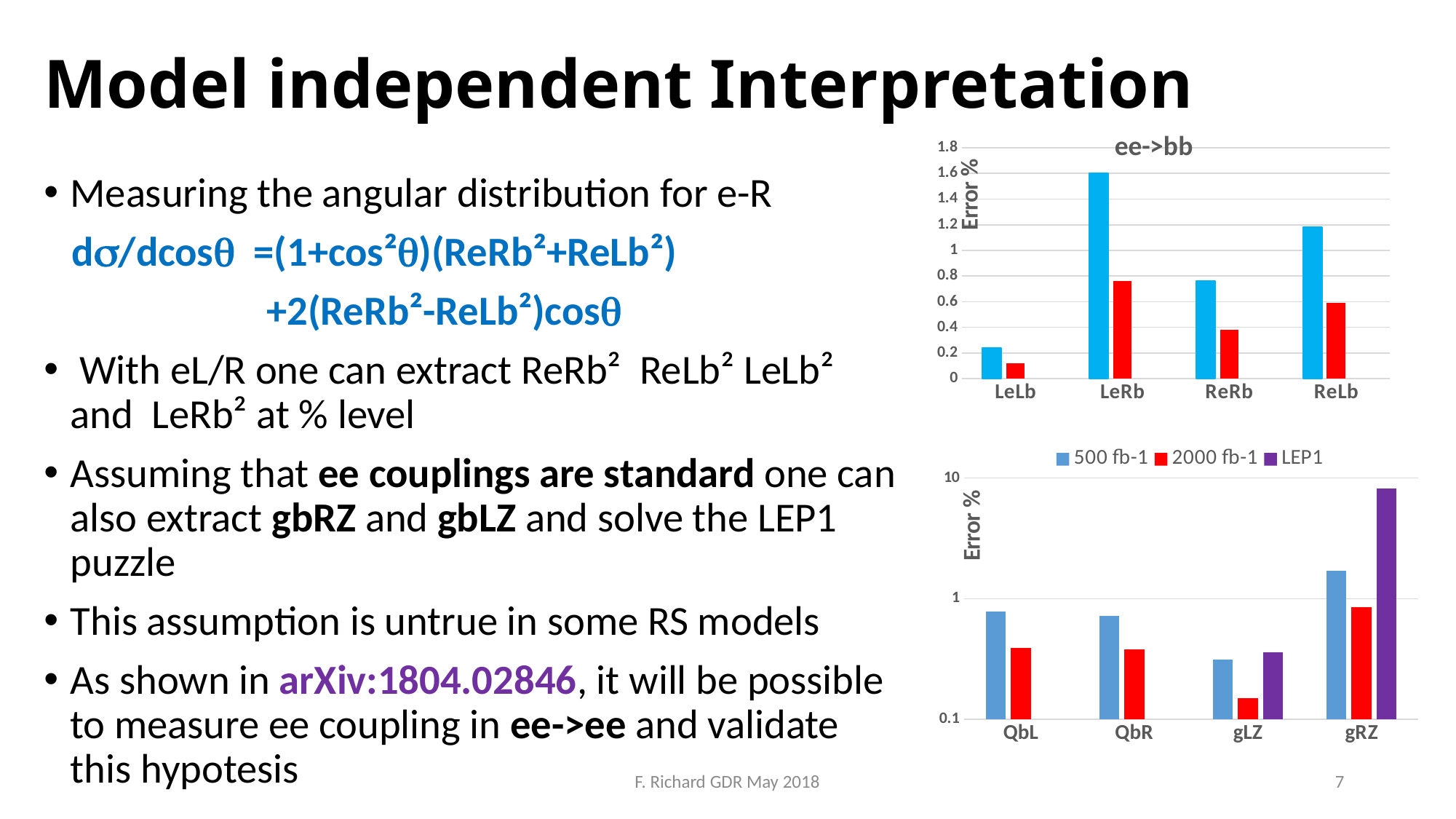
In the top chart titled ee->bb, which category has the tallest bar? LeRb What is the title of the top chart? ee->bb In the top chart titled ee->bb, how many categories are shown on the x axis? 4 In the bottom chart, which category has the tallest bar? gRZ What kind of chart is the top chart titled ee->bb? bar chart In the top chart titled ee->bb, which category has the shortest bars? LeLb In the top chart titled ee->bb, is the blue bar for LeRb greater or less than 1.4? greater In the bottom chart, is the LEP1 value for gRZ greater or less than 1? greater How many series does the legend of the bottom chart list? 3 In the top chart titled ee->bb, is the red bar for ReRb greater or less than 0.6? less In the top chart titled ee->bb, which has the larger blue bar, ReRb or ReLb? ReLb In the bottom chart, how many categories are shown on the x axis? 4